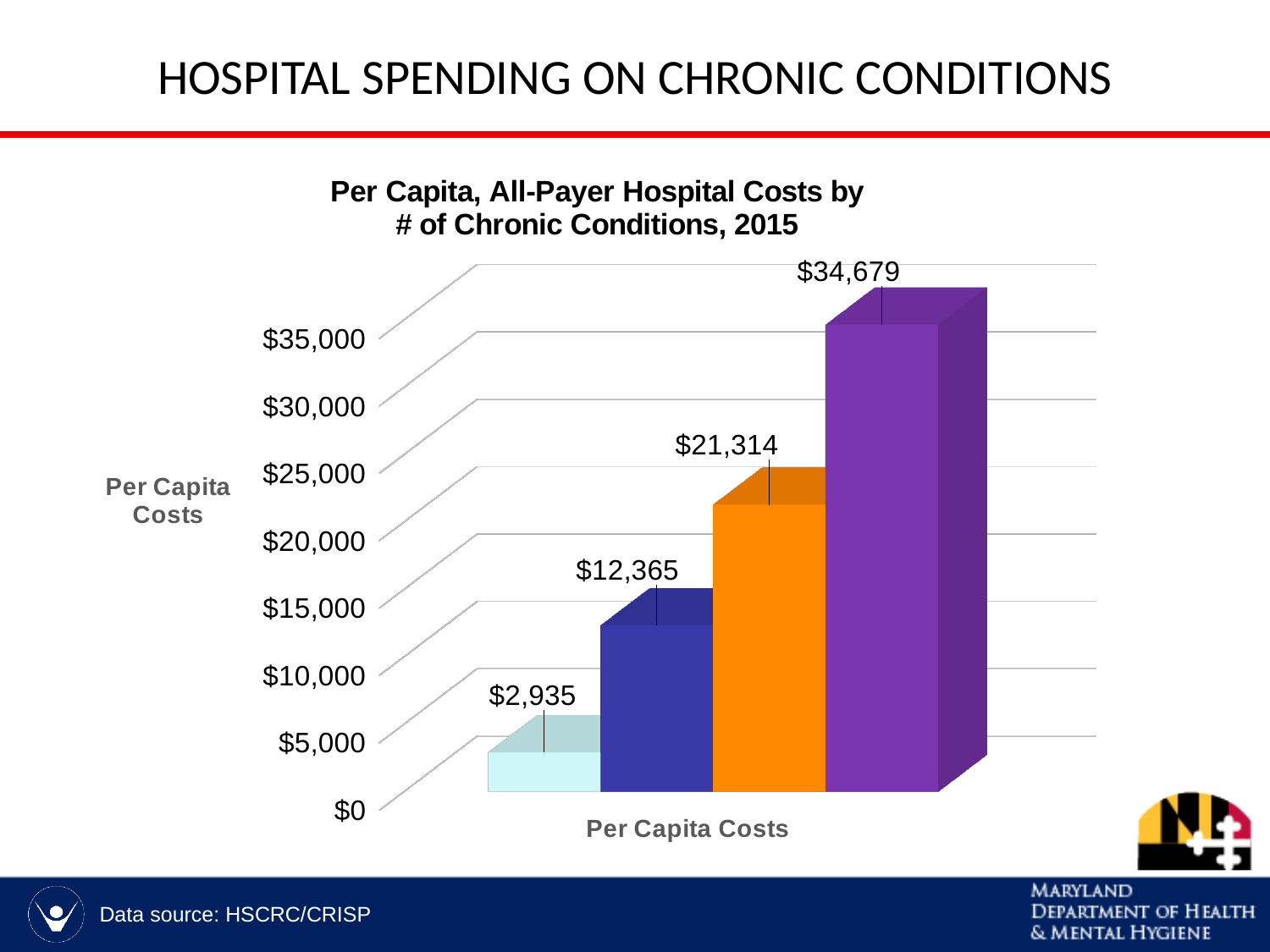
What is the difference between the purple bar's value and the orange bar's value? $13,365 Which bar has the larger value, the orange bar or the dark blue bar? The orange bar How many bars are plotted in the chart? 4 What is the difference between the dark blue bar's value and the light blue bar's value? $9,430 What is the value shown on the tallest bar in the chart? $34,679 What value is labelled on the dark blue bar (second from the left)? $12,365 What is the value shown on the shortest bar in the chart? $2,935 What value is labelled on the orange bar? $21,314 What kind of chart is shown on the slide? Bar chart Do the bar values rise or fall from left to right across the chart? Rise What value is labelled on the purple bar (rightmost)? $34,679 What value is labelled on the light blue bar (leftmost)? $2,935